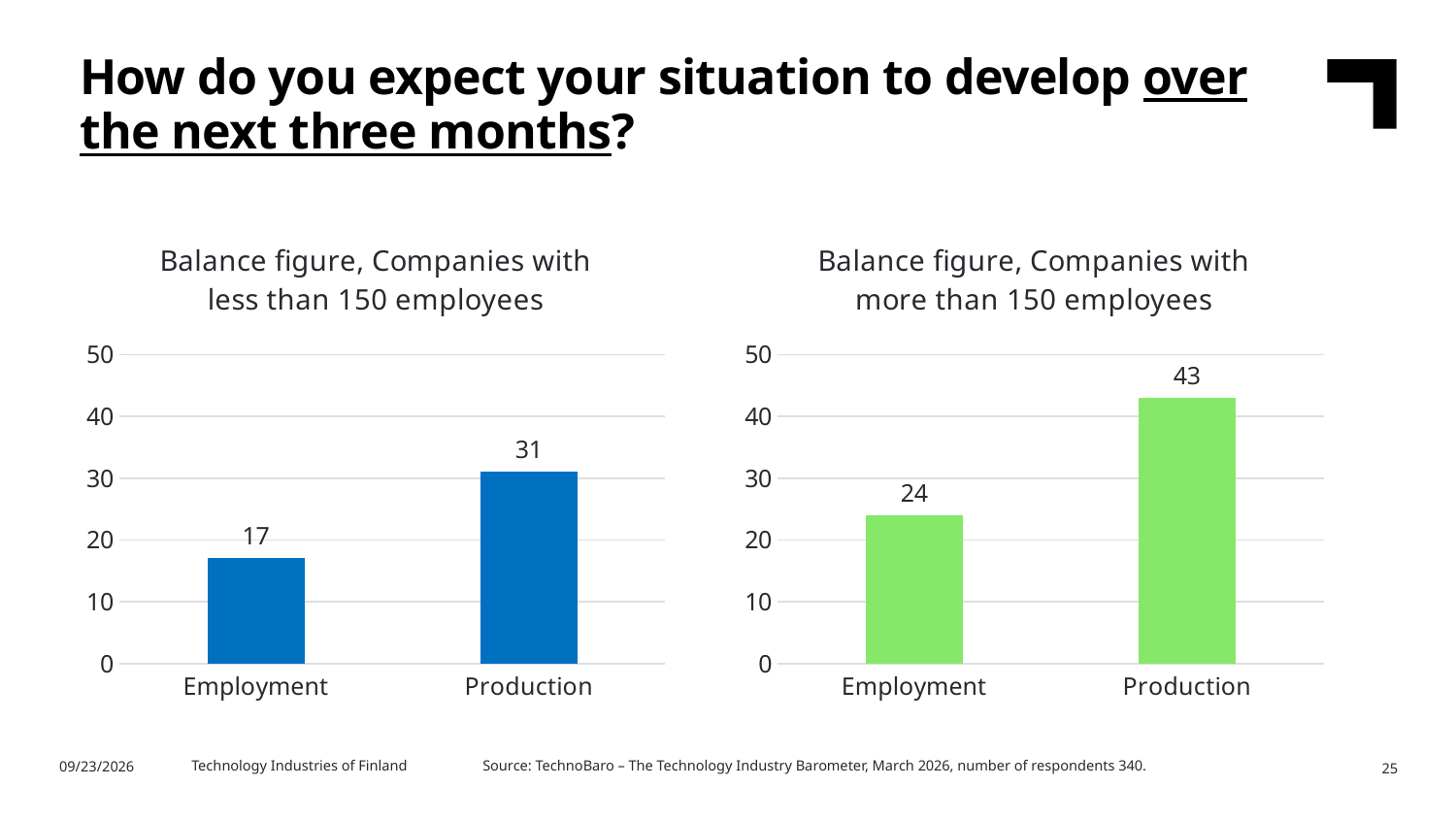
In the right chart (more than 150 employees), which category has the lowest value? Employment In the right chart (more than 150 employees), is the value for Production greater or less than 40? greater In the chart titled "Balance figure, Companies with more than 150 employees", what is the value for Production? 43 In the chart titled "Balance figure, Companies with less than 150 employees", what is the value for Production? 31 In the right chart (more than 150 employees), what is the difference between the Production and Employment values? 19 In the chart titled "Balance figure, Companies with more than 150 employees", what is the value for Employment? 24 In the left chart (less than 150 employees), which category has the highest value? Production How many categories are shown in the left chart (less than 150 employees)? 2 In the chart titled "Balance figure, Companies with less than 150 employees", what is the value for Employment? 17 Which is larger: the Production value in the left chart (less than 150 employees) or the Production value in the right chart (more than 150 employees)? Right chart (more than 150 employees) In the left chart (less than 150 employees), what is the difference between the Production and Employment values? 14 What kind of chart is the chart titled "Balance figure, Companies with more than 150 employees"? Bar chart